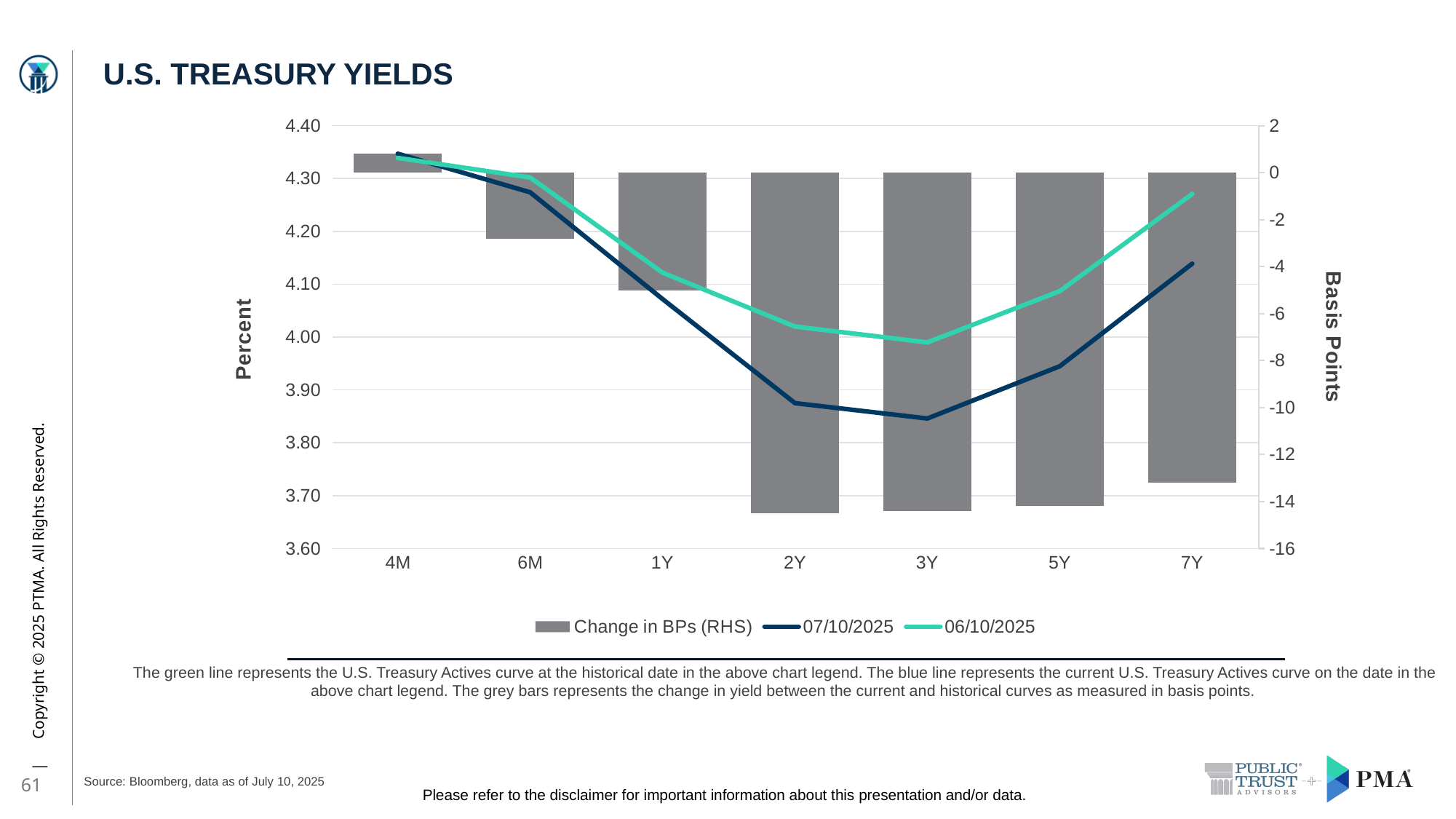
Which maturity has the highest Change in BPs bar? 4M What type of chart is shown on the slide? A combination bar and line chart At 2Y, which line is higher, 07/10/2025 or 06/10/2025? 06/10/2025 Is the Change in BPs value for 6M greater or less than 0? less What is the label of the left vertical axis? Percent Is the Change in BPs value for 7Y greater or less than -14? greater How many series does the legend list? 3 Is the Change in BPs value for 4M greater or less than 0? greater How many maturity categories are shown on the x axis? 7 Which series is plotted as grey bars? Change in BPs (RHS)